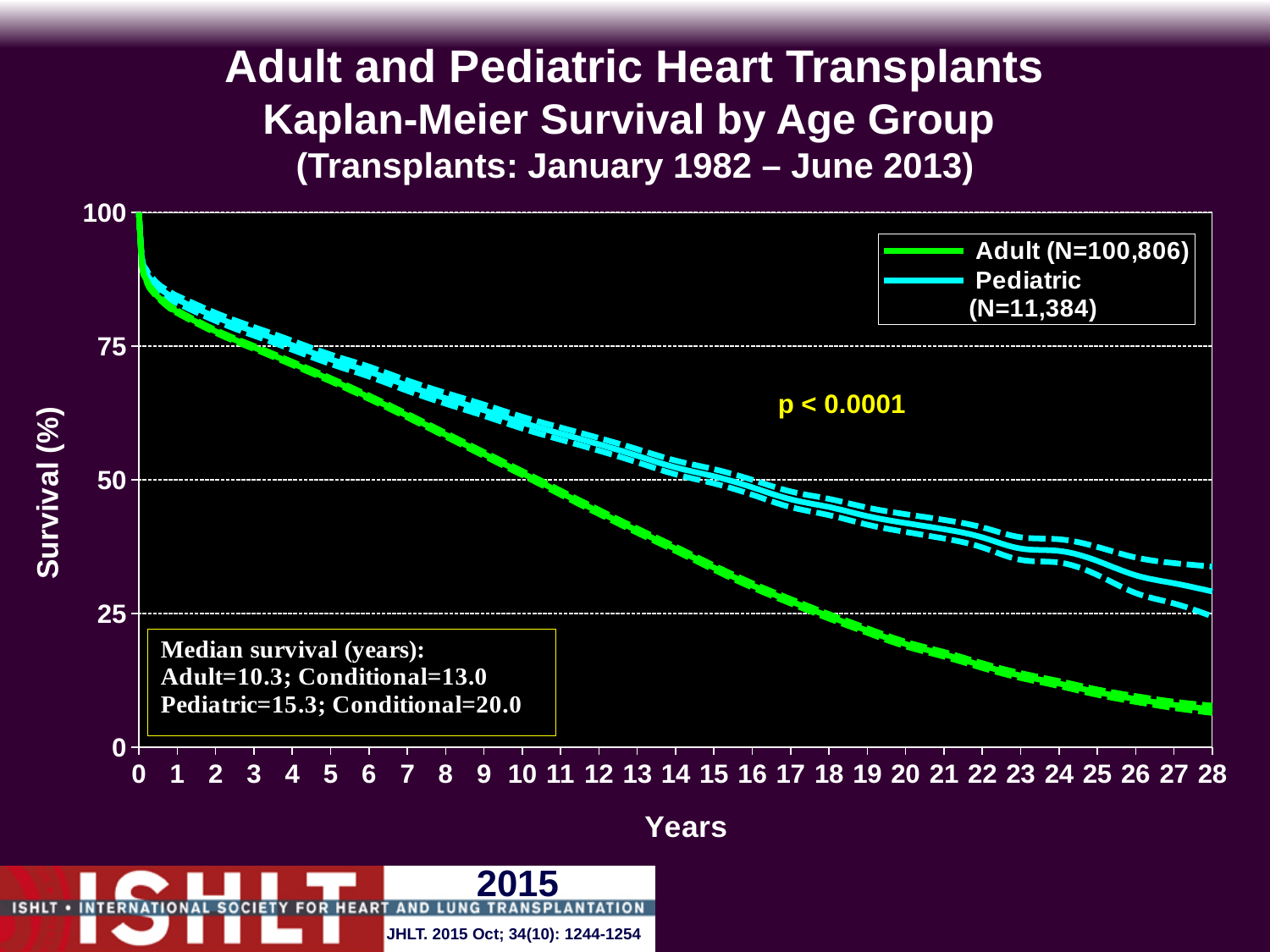
Is the Adult survival at 5 years greater or less than 50? greater Is the Pediatric survival at 20 years greater or less than 50? less What p-value is shown on the chart? p < 0.0001 What is the N shown in the legend for the Pediatric series? N=11,384 Which series has the higher survival at 20 years, Adult or Pediatric? Pediatric What is the conditional median survival in years for Pediatric recipients? 20.0 Do the survival curves rise or fall as the years increase? Fall How many series does the legend list? 2 Is the Adult survival at 28 years greater or less than 25? less What kind of chart is shown on the slide? Line chart What is the median survival in years for Adult recipients? 10.3